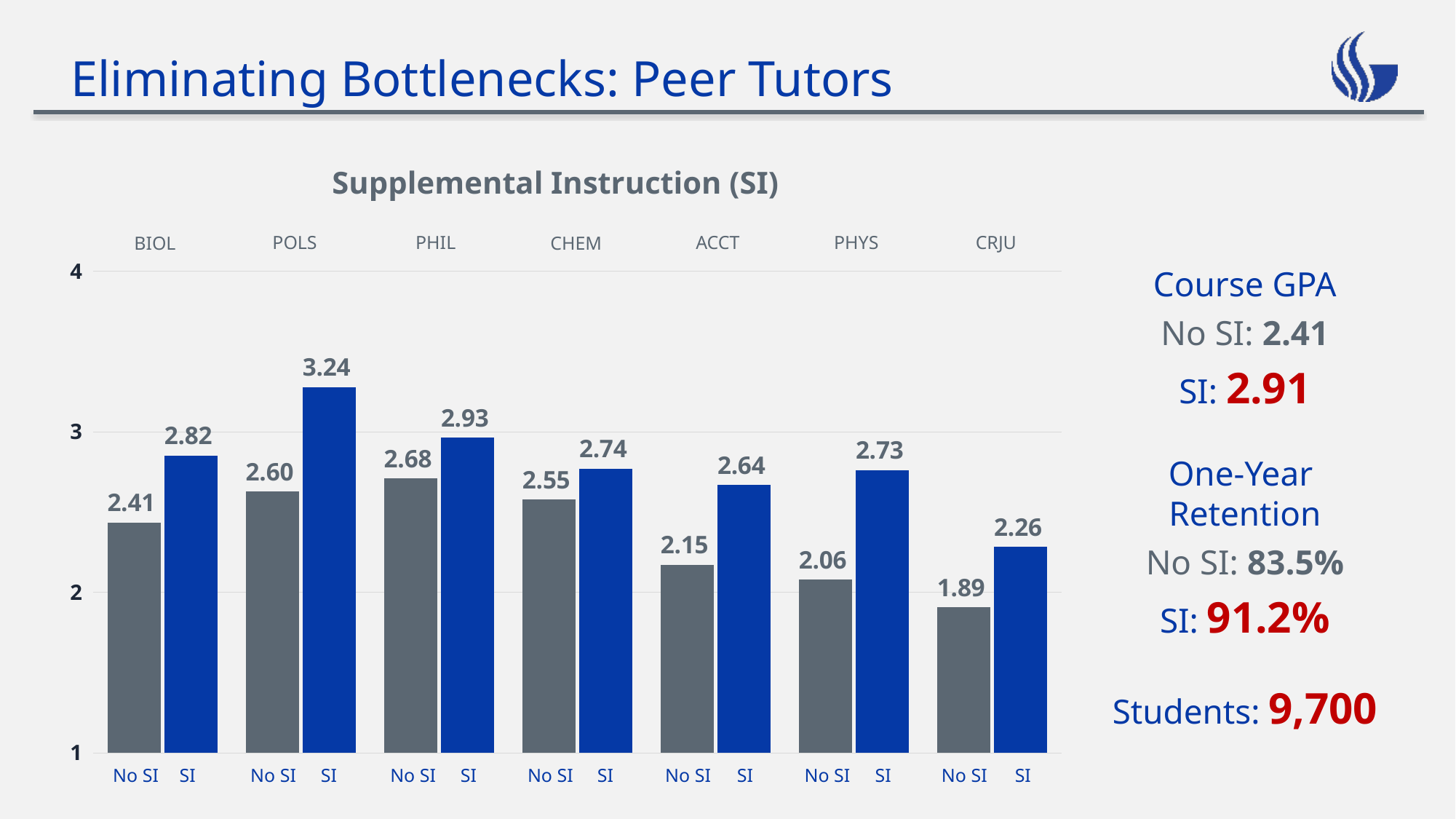
Which is larger, the SI GPA for CHEM or the SI GPA for PHIL? PHIL What is the title of the chart? Supplemental Instruction (SI) What kind of chart is shown on the slide? bar chart What is the SI value for CRJU? 2.26 What is the difference between the SI and No SI GPA for BIOL? 0.41 What is the SI course GPA for POLS? 3.24 What is the No SI course GPA for PHYS? 2.06 Which course has the lowest No SI GPA? CRJU Which course has the highest SI GPA? POLS How many courses are shown on the x axis of the chart? 7 What is the difference between the SI and No SI GPA for PHYS? 0.67 Is the No SI value for ACCT greater or less than 2? greater